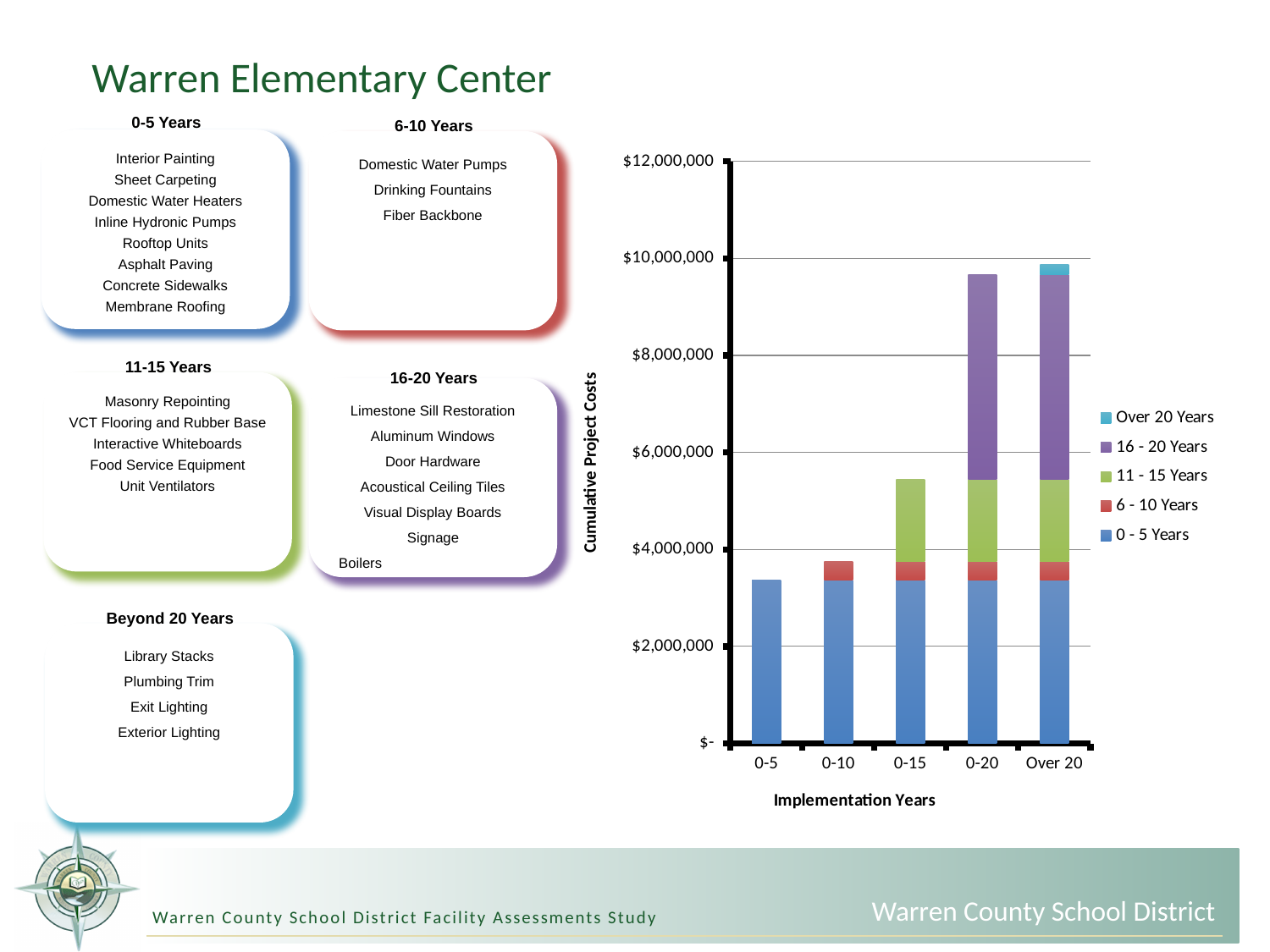
How many series does the chart legend list? 5 Which has a higher cumulative project cost, the 0-15 category or the 0-20 category? 0-20 Is the cumulative project cost for the 0-20 category greater or less than $8,000,000? greater What kind of chart is shown on the slide? Stacked bar chart Is the cumulative project cost for the 0-10 category greater or less than $4,000,000? less Do the cumulative project costs rise or fall moving from 0-5 to Over 20 along the x axis? Rise What is the title of the chart's vertical axis? Cumulative Project Costs Which implementation-year category has the lowest cumulative project cost? 0-5 Which legend series is shown in purple? 16 - 20 Years Is the cumulative project cost for the 0-5 category greater or less than $4,000,000? less How many implementation-year categories are shown on the x axis of the chart? 5